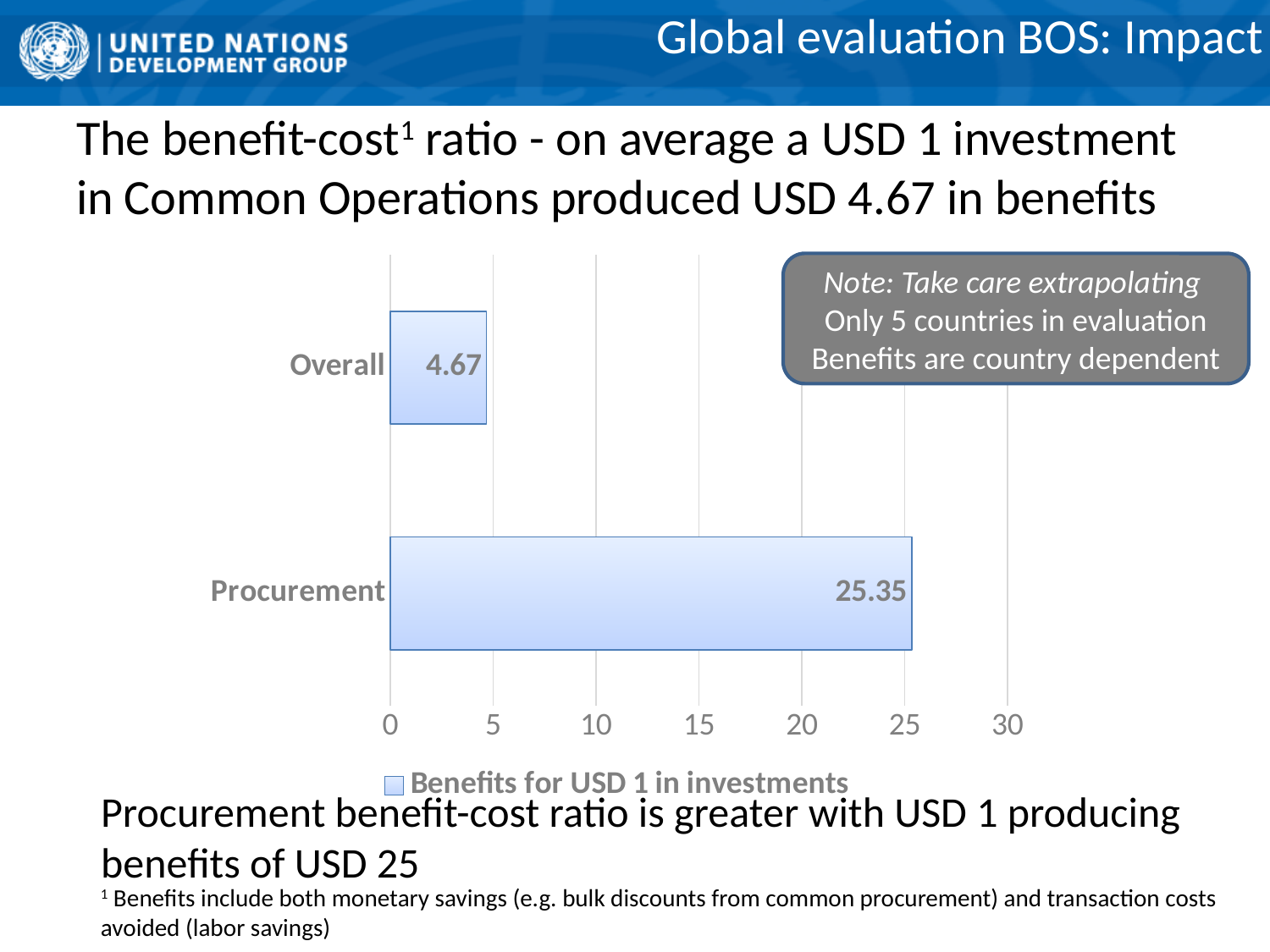
Is the value for Procurement greater or less than 20? greater What is the value for Procurement? 25.35 Which is larger, the value for Procurement or the value for Overall? Procurement Which category has the highest value? Procurement What kind of chart is shown on the slide? Bar chart What is the difference between the Procurement and Overall values? 20.68 Is the value for Overall greater or less than 5? less What is the legend entry for the series in the chart? Benefits for USD 1 in investments How many series does the legend list? 1 Which category has the lowest value? Overall What is the value for Overall? 4.67 How many categories are shown in the chart? 2